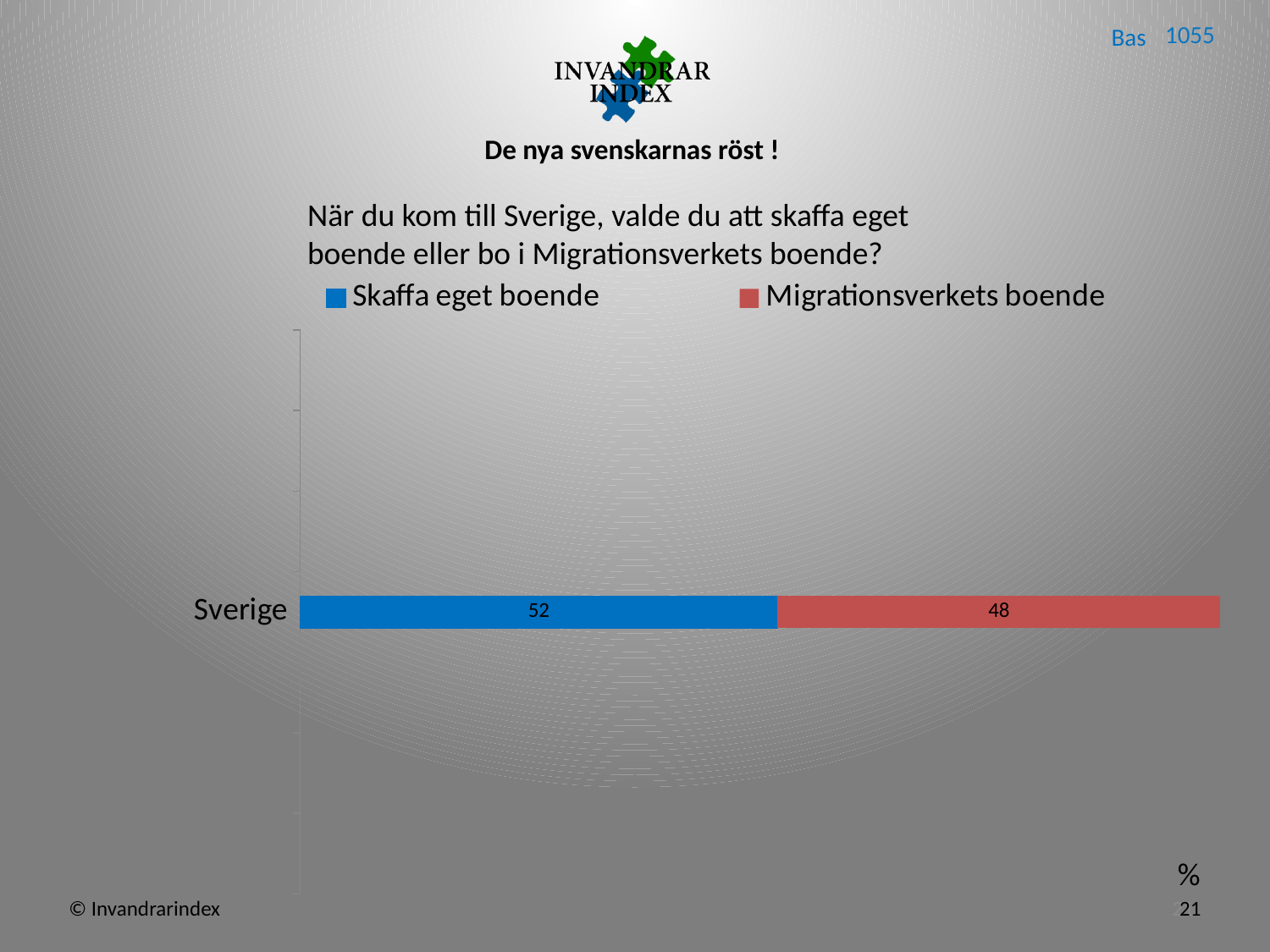
What is the value for Migrationsverkets boende for Sverige? 48 What is the difference between the Skaffa eget boende value and the Migrationsverkets boende value for Sverige? 4 What is the title of the chart? När du kom till Sverige, valde du att skaffa eget boende eller bo i Migrationsverkets boende? Which series has the larger value for Sverige, Skaffa eget boende or Migrationsverkets boende? Skaffa eget boende What is the value for Skaffa eget boende for Sverige? 52 What is the name of the only category on the chart? Sverige Which series is shown in blue? Skaffa eget boende What is the total of the stacked bar for Sverige? 100 How many categories are shown on the chart? 1 What kind of chart is shown on the slide? Stacked bar chart How many series does the legend list? 2